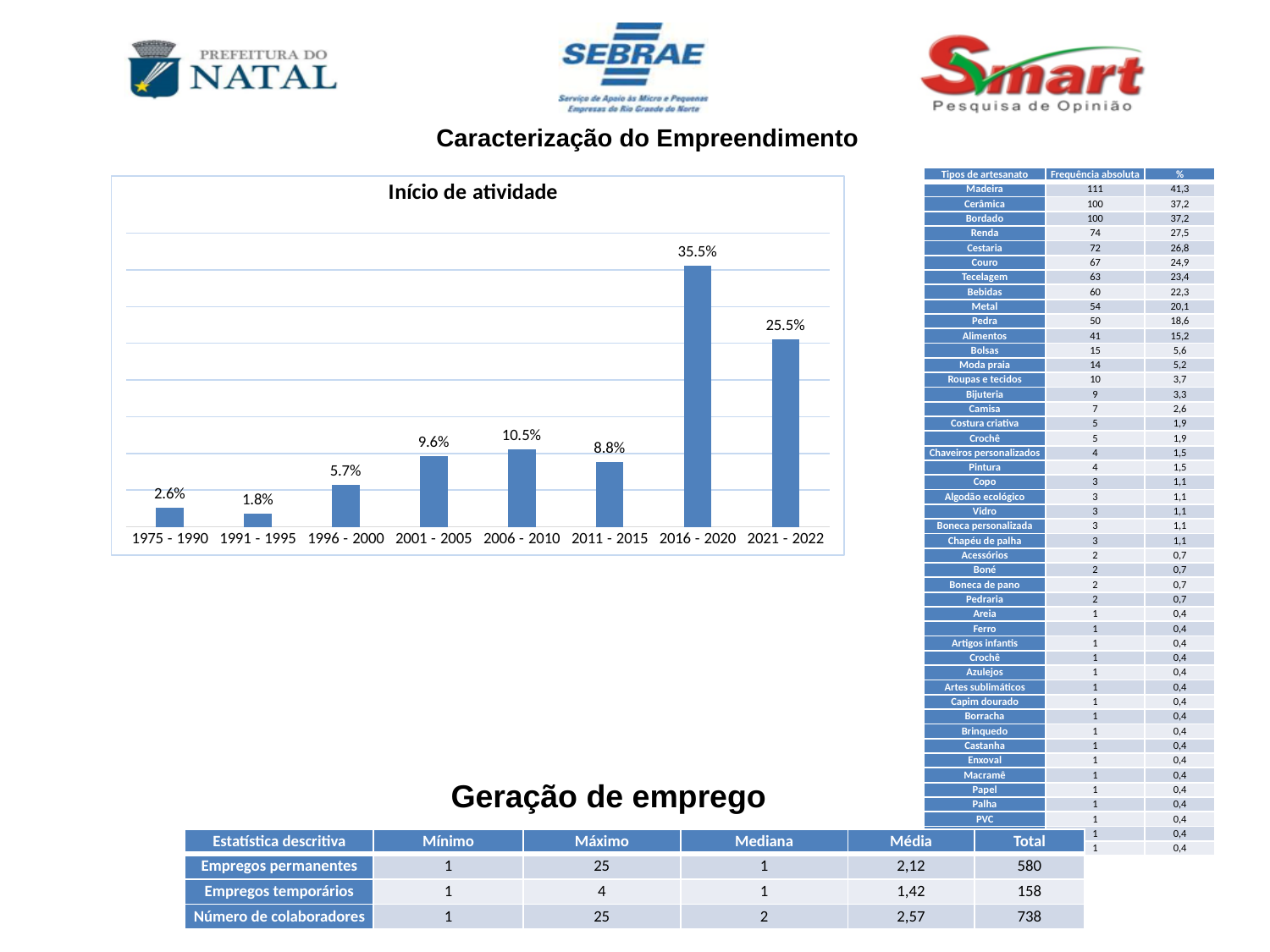
What is the value for 2016 - 2020 in the 'Início de atividade' chart? 35.5% What is the difference between the values for 2016 - 2020 and 2021 - 2022 in the 'Início de atividade' chart? 10% How many periods are shown on the x axis of the 'Início de atividade' chart? 8 Which period has the lowest value in the 'Início de atividade' chart? 1991 - 1995 What is the title of the chart on the slide? Início de atividade What is the difference between the values for 2006 - 2010 and 2001 - 2005 in the 'Início de atividade' chart? 0.9% What is the value for 2006 - 2010 in the 'Início de atividade' chart? 10.5% In the 'Início de atividade' chart, which is larger: the value for 2011 - 2015 or the value for 2001 - 2005? 2001 - 2005 What kind of chart is 'Início de atividade'? Bar chart Which period has the highest value in the 'Início de atividade' chart? 2016 - 2020 What is the value for 2021 - 2022 in the 'Início de atividade' chart? 25.5% What is the value for 1975 - 1990 in the 'Início de atividade' chart? 2.6%